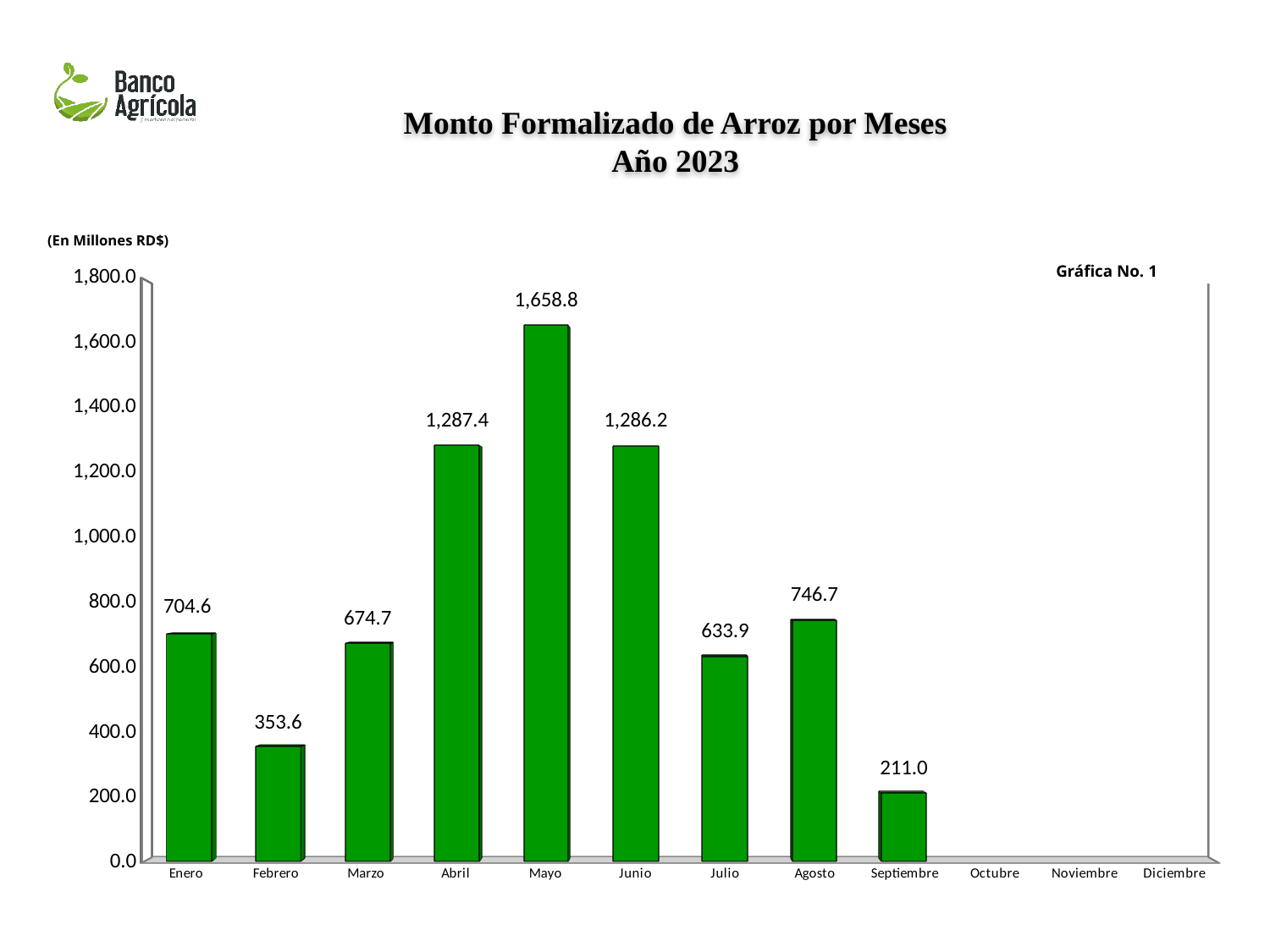
What is the difference between the values for Agosto and Julio? 112.8 Is the value for Mayo greater or less than 1,600.0? greater What is the value for Abril? 1,287.4 Which month with a plotted bar has the lowest value? Septiembre Which is larger, the value for Enero or the value for Marzo? Enero What is the difference between the values for Mayo and Abril? 371.4 Which month has the highest value? Mayo How many months have a plotted bar with a value? 9 What kind of chart is shown? bar chart What is the value for Mayo? 1,658.8 Do the values rise or fall from Febrero to Mayo? rise What is the value for Septiembre? 211.0